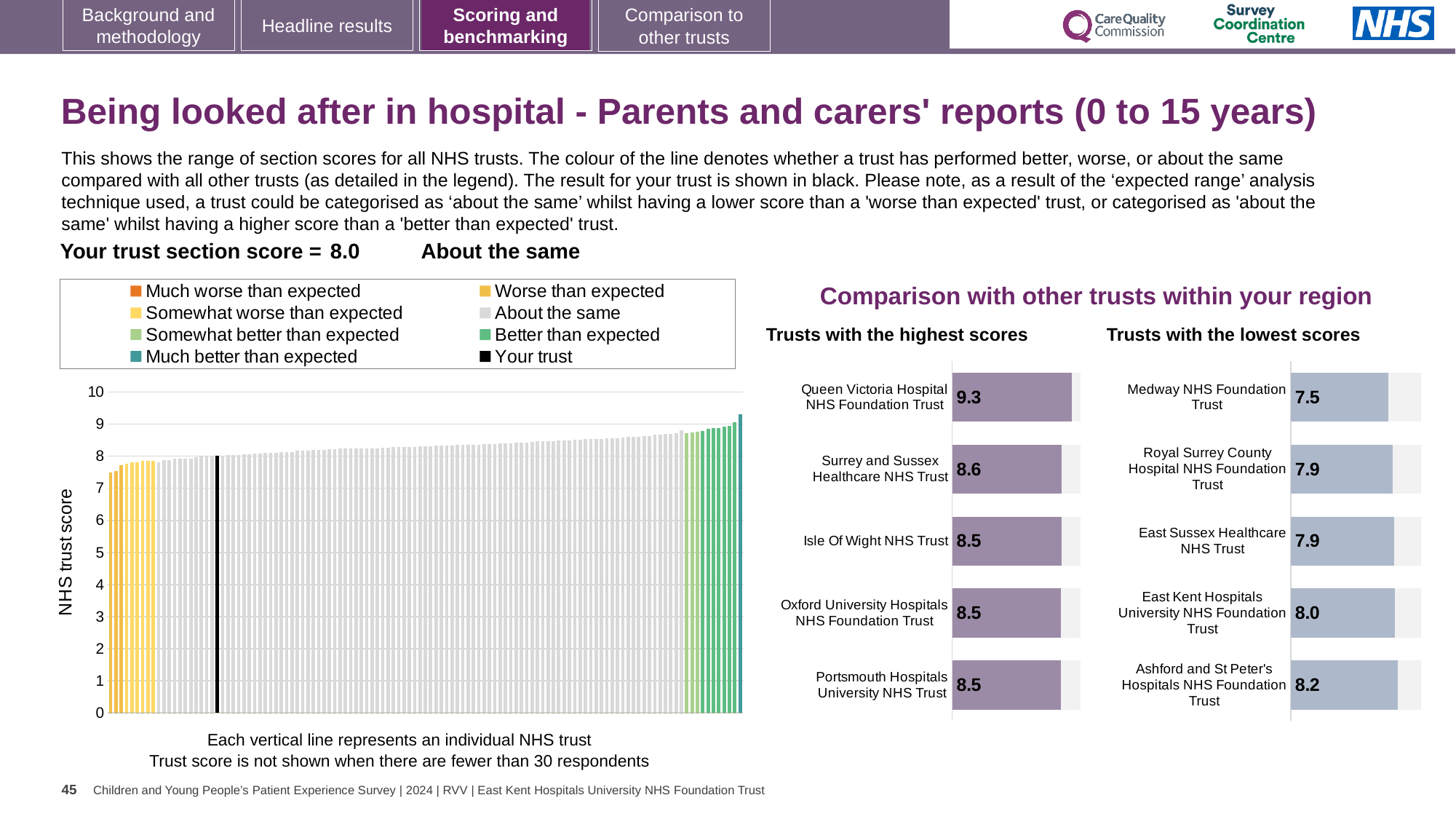
How many entries does the legend of the main 'NHS trust score' chart list? 8 In the 'Trusts with the lowest scores' chart, what is the score for Medway NHS Foundation Trust? 7.5 In the main 'NHS trust score' chart on the left, what is the score for your trust (the black bar)? 8.0 In the 'Trusts with the lowest scores' chart, which has the larger score: Ashford and St Peter's Hospitals NHS Foundation Trust or Royal Surrey County Hospital NHS Foundation Trust? Ashford and St Peter's Hospitals NHS Foundation Trust In the 'Trusts with the lowest scores' chart, what is the score for East Kent Hospitals University NHS Foundation Trust? 8.0 In the main 'NHS trust score' chart on the left, do the bar values rise or fall from left to right? rise In the 'Trusts with the highest scores' chart, which trust has the highest score? Queen Victoria Hospital NHS Foundation Trust In the 'Trusts with the lowest scores' chart, which trust has the lowest score? Medway NHS Foundation Trust How many trusts are shown in the 'Trusts with the highest scores' chart? 5 In the main 'NHS trust score' chart on the left, is the value of the tallest bar greater or less than 9? greater In the 'Trusts with the highest scores' chart, what is the score for Queen Victoria Hospital NHS Foundation Trust? 9.3 In the 'Trusts with the highest scores' chart, what is the difference between the scores of Queen Victoria Hospital NHS Foundation Trust and Surrey and Sussex Healthcare NHS Trust? 0.7